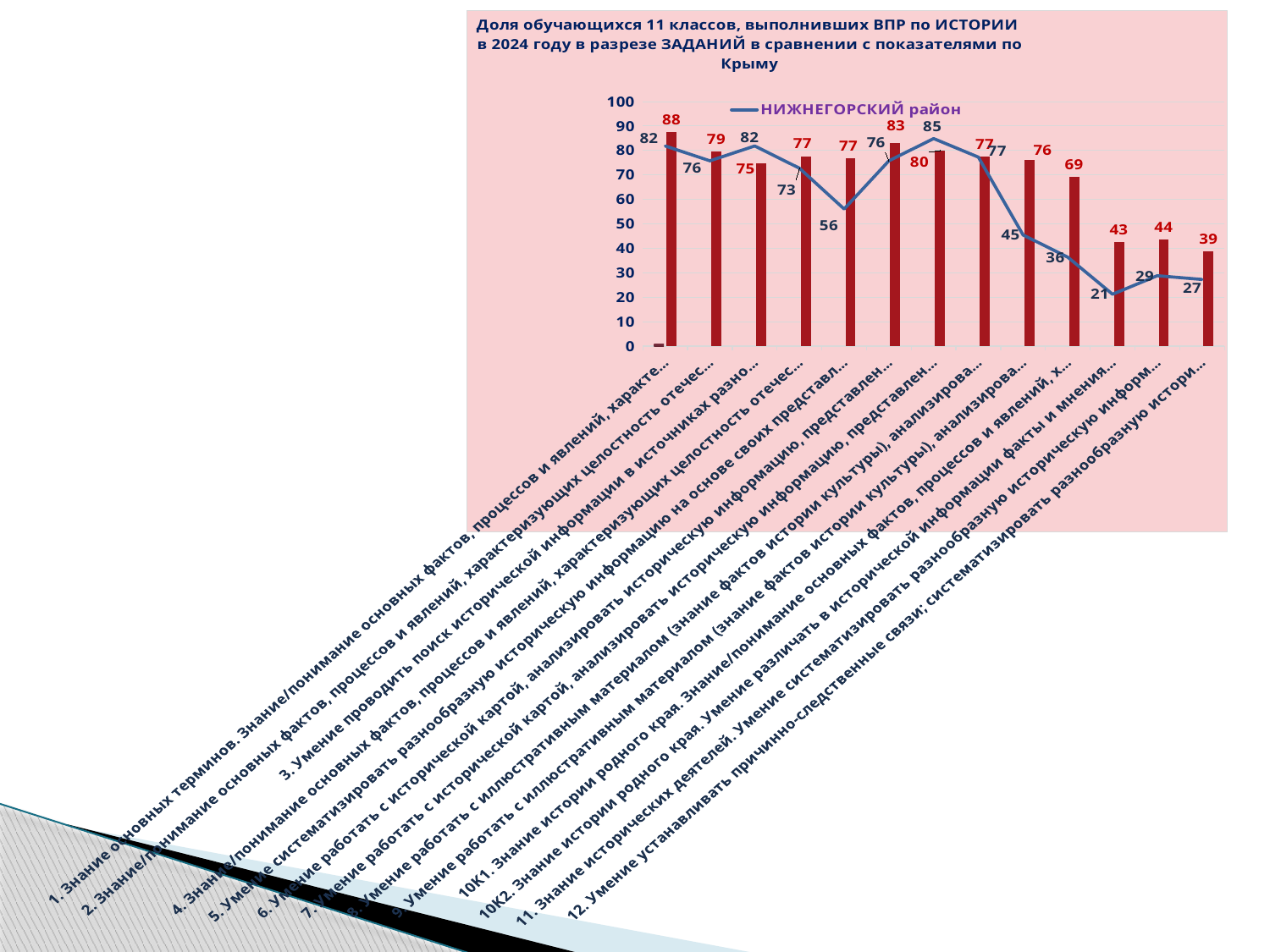
For task 5, what is the difference between the bar value (77) and the НИЖНЕГОРСКИЙ район line value (56)? 21 For task 3, which is larger: the bar value or the НИЖНЕГОРСКИЙ район line value? The НИЖНЕГОРСКИЙ район line value (82 vs 75) For which task does the НИЖНЕГОРСКИЙ район line have its lowest value? Task 10К2 (21) Is the bar value for task 11 greater or less than 50? less How many series does the legend list? 1 How many tasks (categories) are plotted on the x axis? 13 What is the value of the НИЖНЕГОРСКИЙ район line for task 1 (Знание основных терминов)? 82 Which task has the highest bar value? Task 1 (88) Which task has the lowest bar value? Task 12 (39) What kind of chart is shown on the slide? A combined bar and line chart For which task does the НИЖНЕГОРСКИЙ район line reach its highest value? Task 7 (85) What is the value of the bar for task 12 (Умение устанавливать причинно-следственные связи)? 39